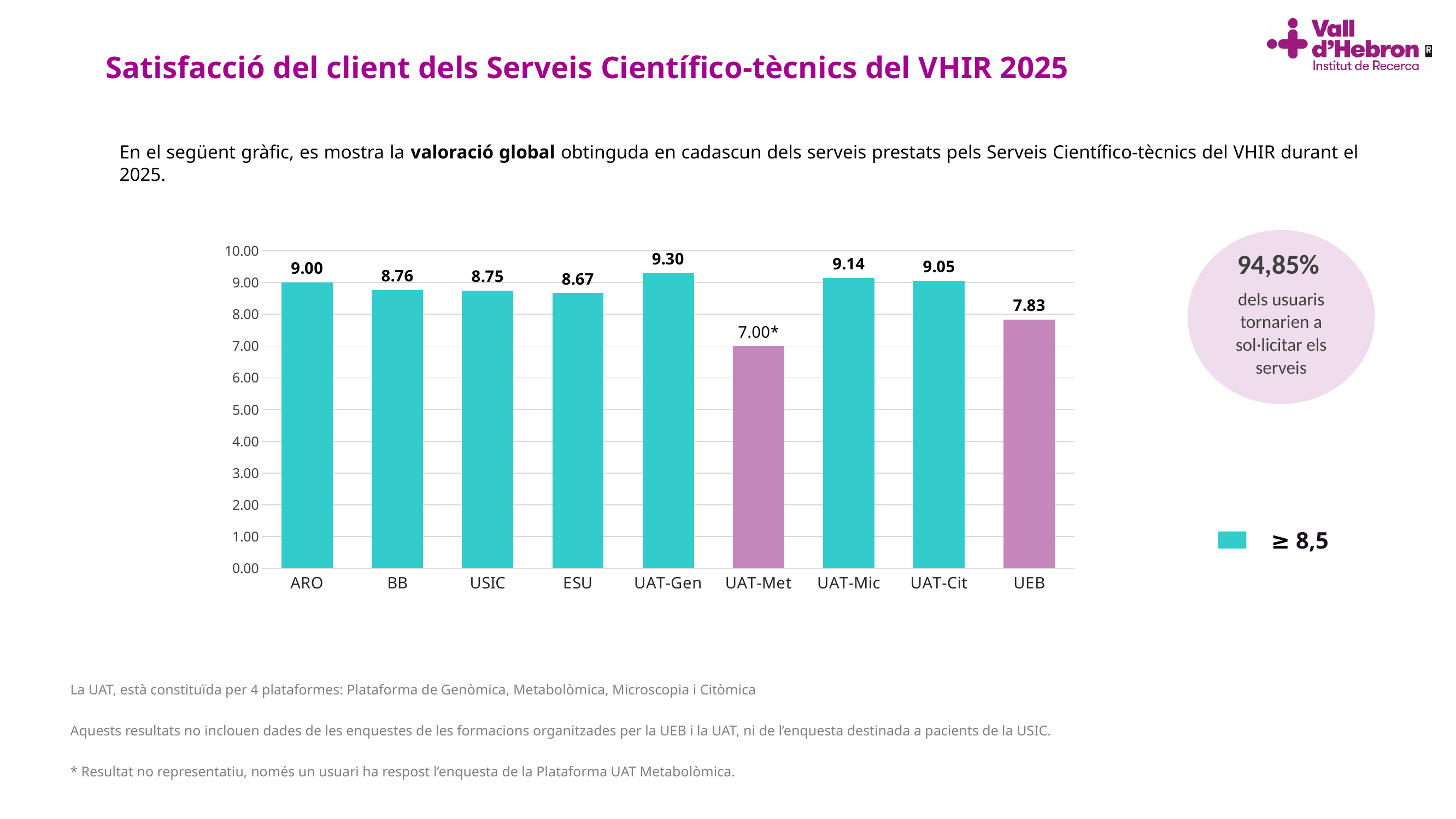
What is the difference between the values for UAT-Gen and UEB? 1.47 Which category has the highest value? UAT-Gen Which category has the lowest value? UAT-Met Which is larger, the value for UAT-Mic or the value for UAT-Cit? UAT-Mic What is the value for UEB? 7.83 What is the value for UAT-Gen? 9.30 What is the value for ARO? 9.00 Is the value for UEB greater or less than 8.00? less What kind of chart is shown on the slide? bar chart How many categories are shown on the x axis? 9 What is the value for ESU? 8.67 What does the legend entry with the teal colour indicate? ≥ 8,5